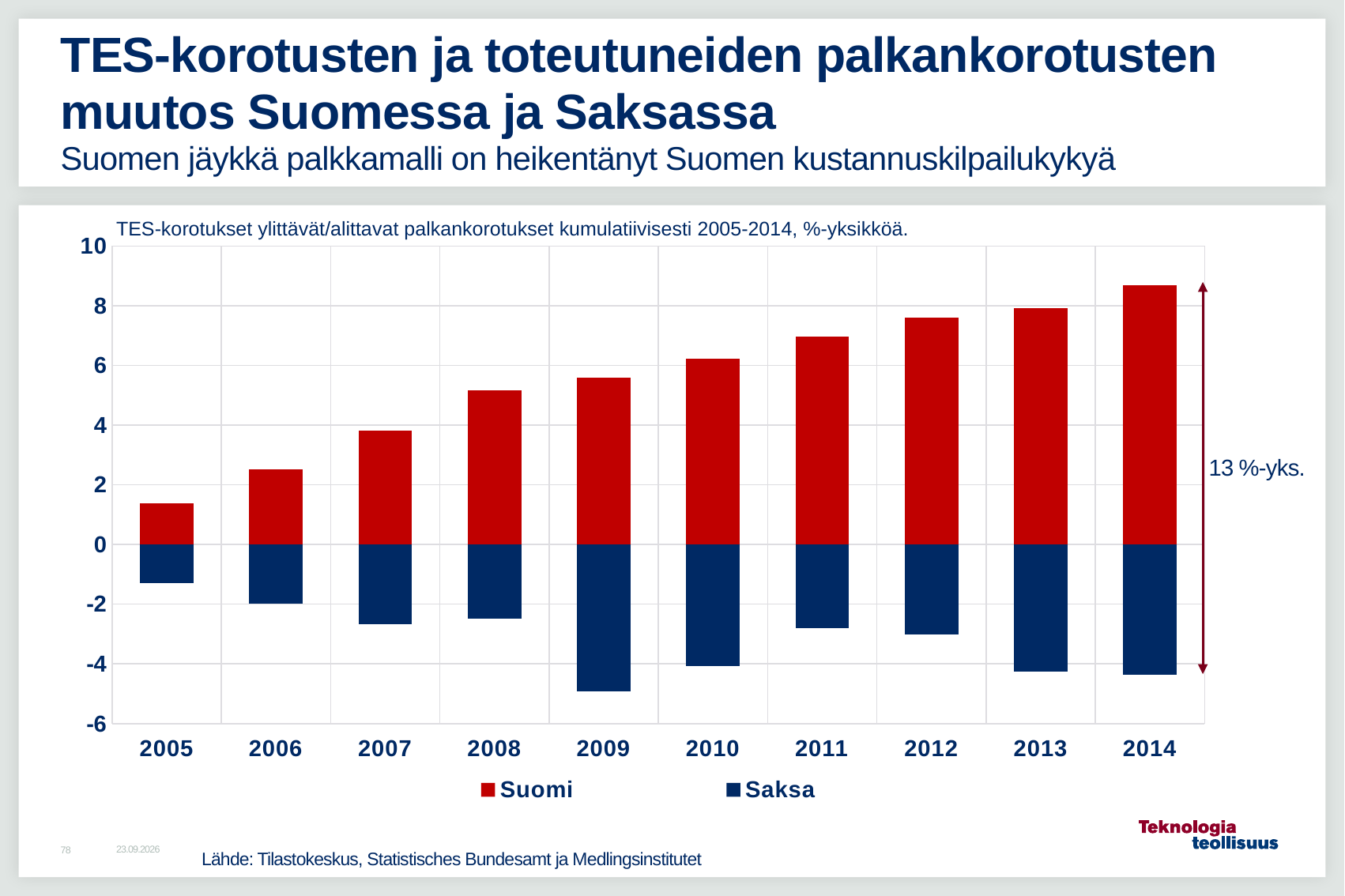
How many series does the chart legend list? 2 Do the Suomi values rise or fall from 2005 to 2014? rise Is the Suomi value for 2014 greater or less than 8? greater In which year is the Suomi value highest? 2014 Is the Suomi value for 2005 greater or less than 2? less In which year is the Suomi value lowest? 2005 Which series are listed in the chart legend? Suomi and Saksa What kind of chart is shown on the slide? bar chart In which year does the Saksa bar extend furthest below zero? 2009 How many years are shown on the x axis of the chart? 10 Is the Saksa value for 2009 greater or less than -4? less Which is larger, the Suomi value for 2007 or for 2008? 2008